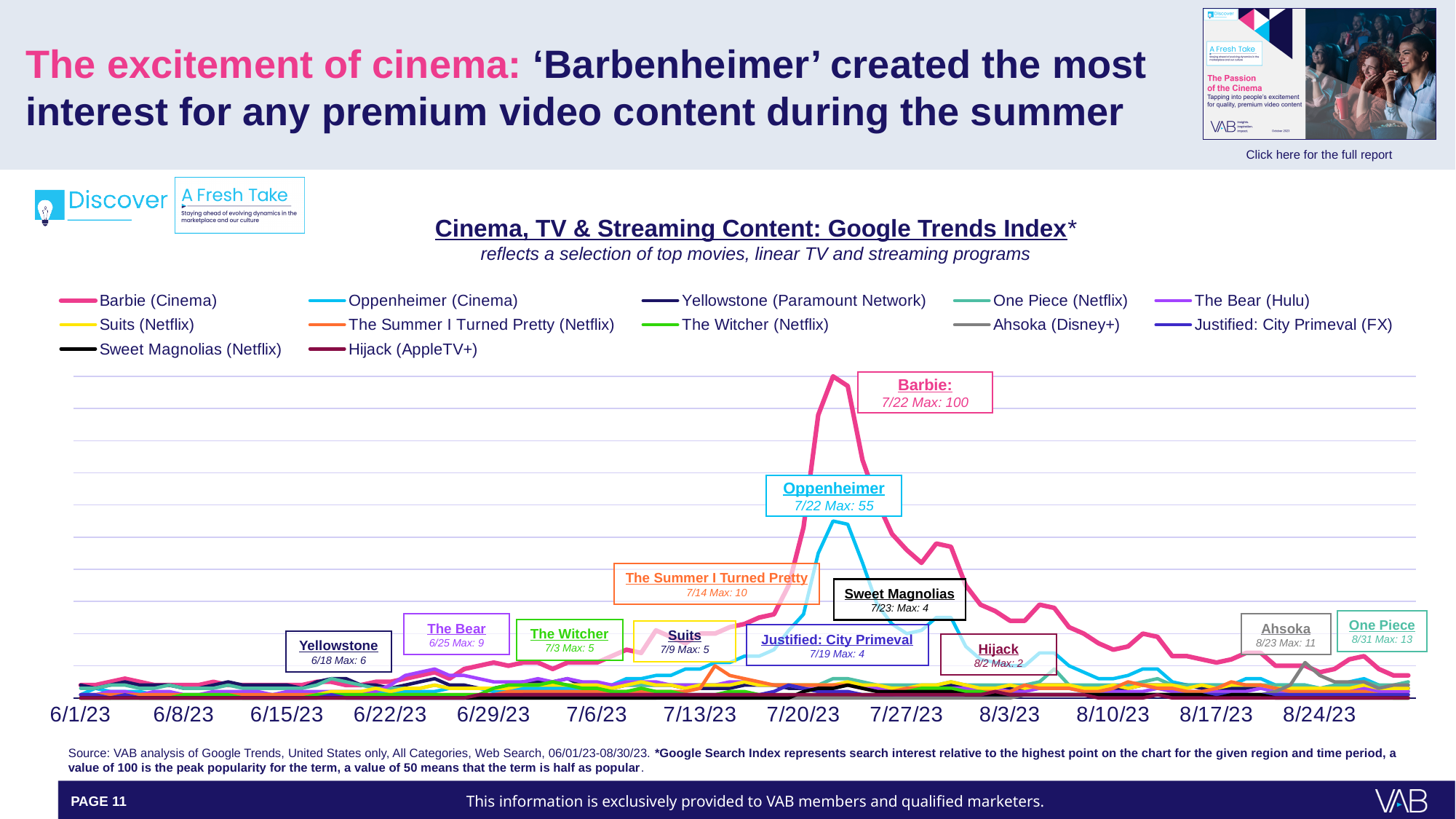
How many series does the legend list? 12 Which annotated series has the lowest maximum value? Hijack Which series reaches the highest peak on the chart? Barbie (Cinema) On what date did Hijack reach its maximum index value? 8/2 Which has a higher maximum value, Ahsoka or The Bear? Ahsoka What is the title of the chart? Cinema, TV & Streaming Content: Google Trends Index What is the maximum index value shown for One Piece? 13 What kind of chart is shown on the slide? Line chart What is the difference between the maximum values of Barbie and Oppenheimer? 45 What is the maximum index value shown for The Summer I Turned Pretty? 10 What is the peak Google Trends Index value for Barbie (Cinema)? 100 On what date did Oppenheimer reach its maximum index value? 7/22